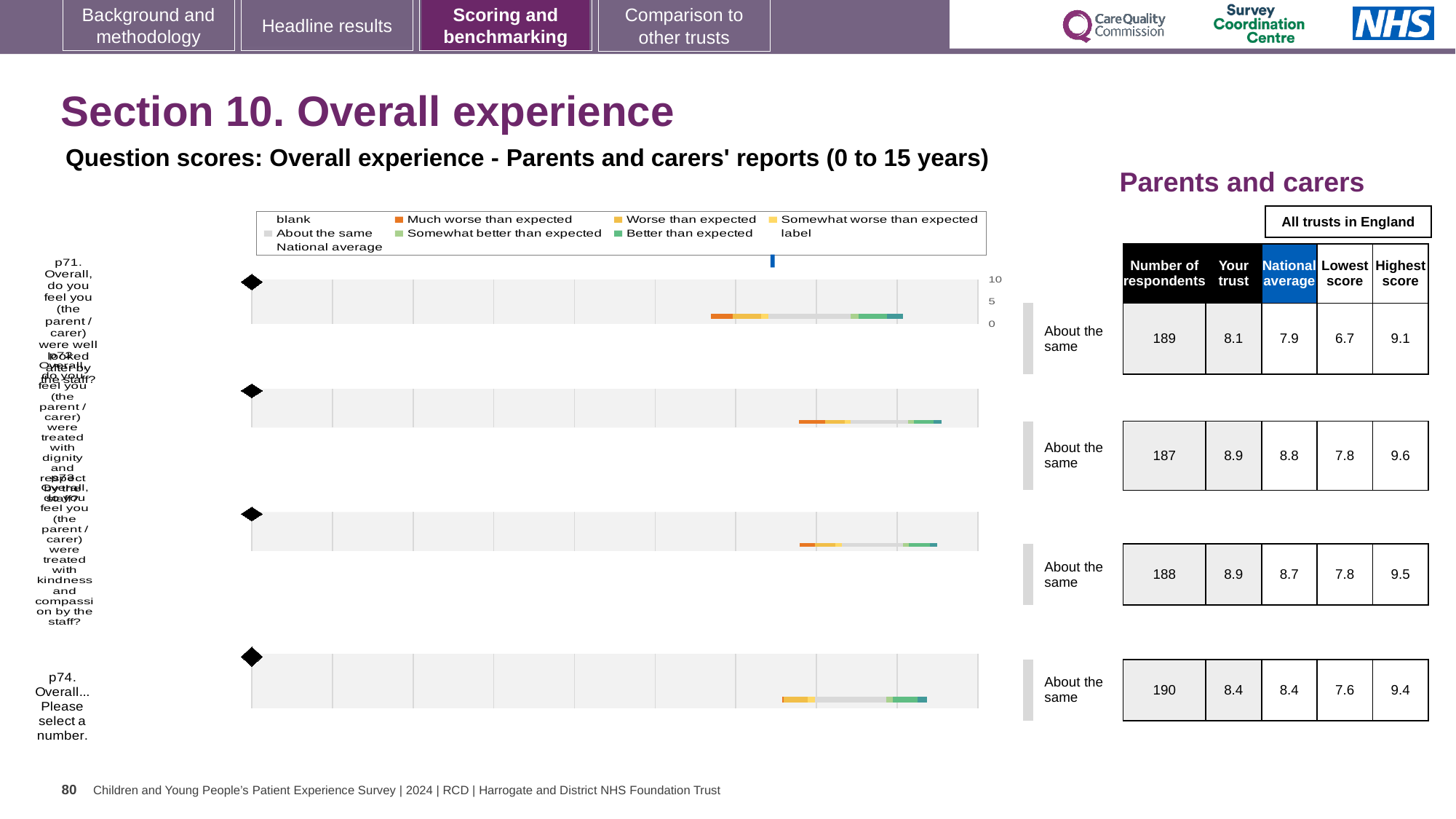
What is the highest tick value shown on the chart's axis? 10 How many question rows (bars) are plotted in the chart? 4 In the table beside the chart, which row has the lowest 'Lowest score' value? p71 (6.7) In the table beside the chart, what is the number of respondents for the second row (p72)? 187 How many entries does the chart legend list? 9 In the table beside the chart, what is the 'Your trust' score for the first row (p71)? 8.1 In the table beside the chart, what is the difference between 'Your trust' and the National average for the first row (p71)? 0.2 In the table beside the chart, what is the National average for the last row (p74)? 8.4 What kind of chart is shown on the slide? bar chart In the table beside the chart, which row has the highest 'Highest score' value? p72 (9.6) Which legend entry is shown in orange? Much worse than expected In the table beside the chart, is the 'Your trust' score for the third row (p73) larger or smaller than its National average? larger